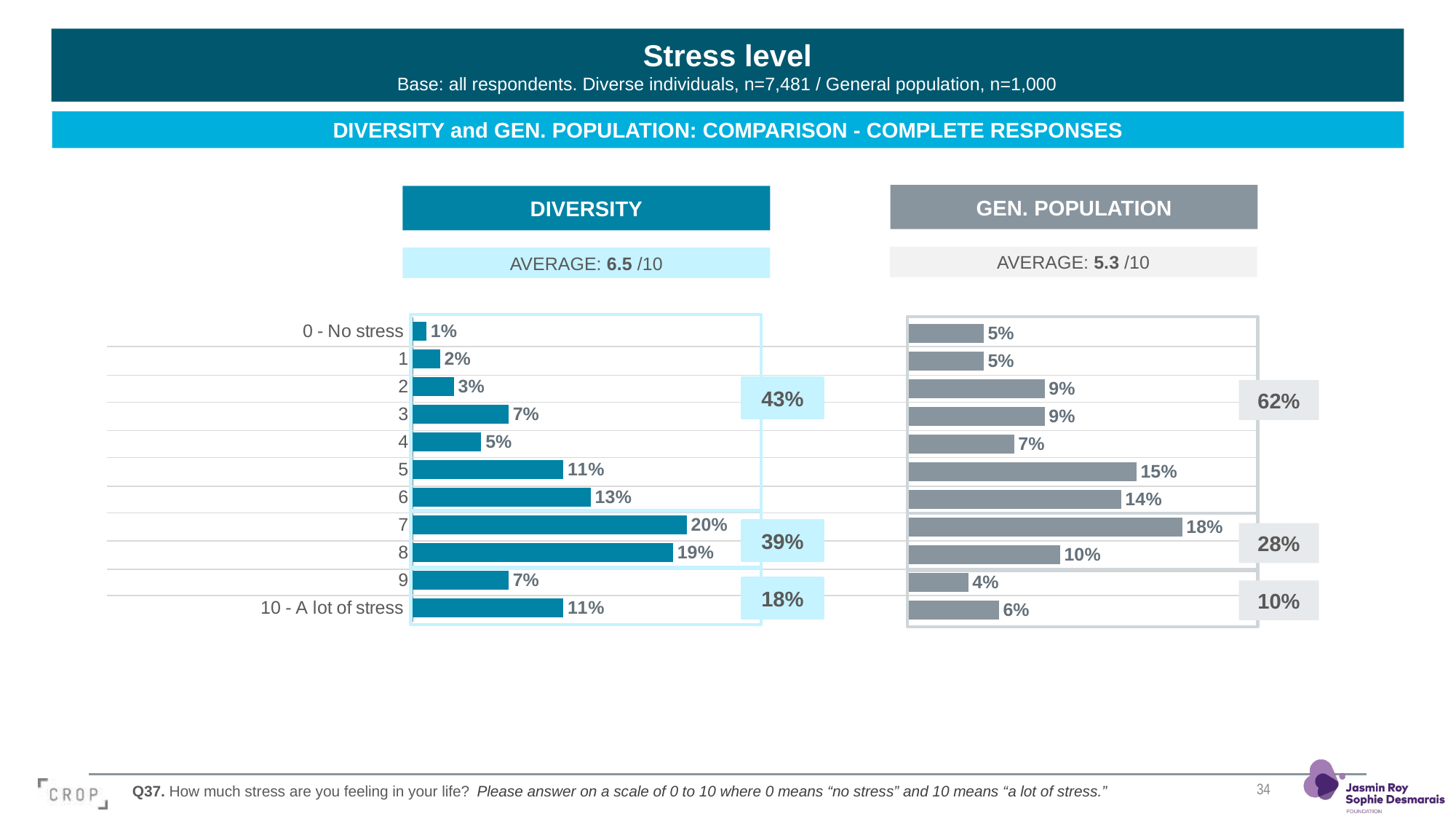
In the DIVERSITY chart, which stress level has the lowest percentage? 0 - No stress For stress level 3, which chart shows the larger percentage, DIVERSITY or GEN. POPULATION? GEN. POPULATION In the GEN. POPULATION chart, what percentage of respondents rated their stress level as 5? 15% In the DIVERSITY chart, what percentage of respondents chose '10 - A lot of stress'? 11% In the DIVERSITY chart, which stress level has the highest percentage? 7 What is the difference between the DIVERSITY and GEN. POPULATION percentages for stress level 8? 9% In the GEN. POPULATION chart, which stress level has the lowest percentage? 9 What type of chart is used to show the stress level distributions? Bar chart In the DIVERSITY chart, what percentage of respondents rated their stress level as 7? 20% How many stress level categories are shown in the DIVERSITY chart? 11 What is the average stress score shown for the GEN. POPULATION group? 5.3 /10 In the GEN. POPULATION chart, what percentage of respondents chose '0 - No stress'? 5%